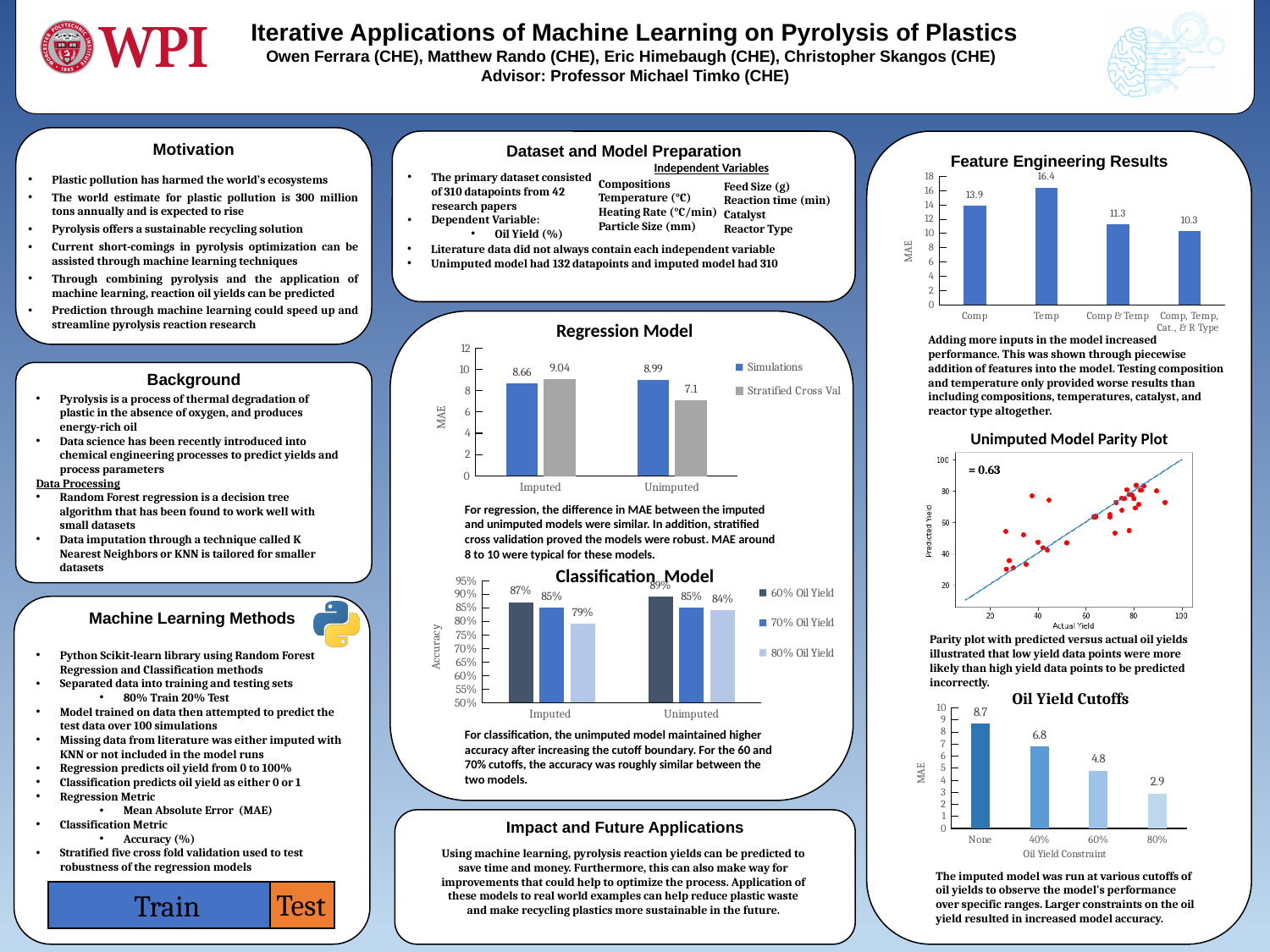
In the Feature Engineering Results chart, which category has the lowest MAE? Comp, Temp, Cat., & R Type In the Oil Yield Cutoffs chart, what is the MAE for the 60% oil yield constraint? 4.8 In the Regression Model chart, which is larger for the Imputed model: Simulations or Stratified Cross Val? Stratified Cross Val In the Classification Model chart, how many series does the legend list? 3 In the Classification Model chart, what is the accuracy for the 80% Oil Yield cutoff on the Imputed model? 79% In the Regression Model chart, how many series does the legend list? 2 In the Oil Yield Cutoffs chart, do the MAE values rise or fall as the oil yield constraint increases along the x axis? Fall In the Feature Engineering Results chart, what is the MAE for Temp? 16.4 In the Classification Model chart, what is the difference in 80% Oil Yield accuracy between the Unimputed and Imputed models? 5% What kind of chart is the Unimputed Model Parity Plot? Scatter plot In the Regression Model chart, what is the Stratified Cross Val MAE for the Unimputed model? 7.1 In the Feature Engineering Results chart, what is the difference in MAE between Temp and Comp & Temp? 5.1